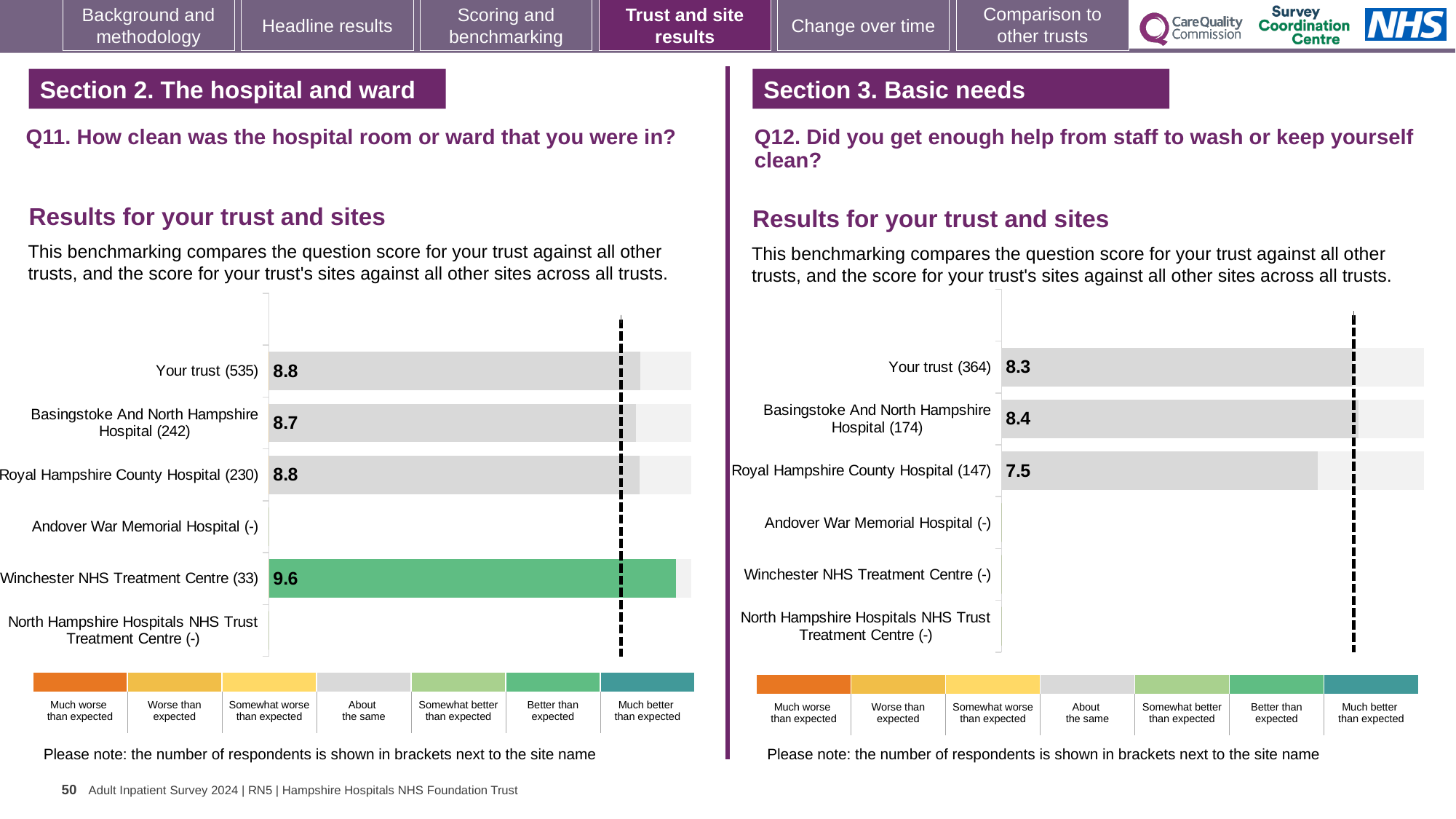
What kind of chart is used for the Q11 results on the left? Bar chart On the Q12 chart (right), which is larger: the score for Basingstoke And North Hampshire Hospital or the score for Royal Hampshire County Hospital? Basingstoke And North Hampshire Hospital On the Q11 chart (left), which bar is coloured green rather than grey? Winchester NHS Treatment Centre (33) On the Q11 chart (left), what is the score for Winchester NHS Treatment Centre (33)? 9.6 On the Q11 chart (left), what is the score for Your trust (535)? 8.8 On the Q12 chart (right), what is the difference between the Basingstoke And North Hampshire Hospital score and the Royal Hampshire County Hospital score? 0.9 On the Q11 chart (left), which site has the highest score? Winchester NHS Treatment Centre (33) On the Q11 chart (left), what is the score for Basingstoke And North Hampshire Hospital (242)? 8.7 On the Q12 chart (right), what is the score for Royal Hampshire County Hospital (147)? 7.5 On the Q11 chart (left), what is the difference between the Winchester NHS Treatment Centre score and the Your trust score? 0.8 On the Q12 chart (right), what is the score for Your trust (364)? 8.3 On the Q12 chart (right), which site with a score shown has the lowest score? Royal Hampshire County Hospital (147)